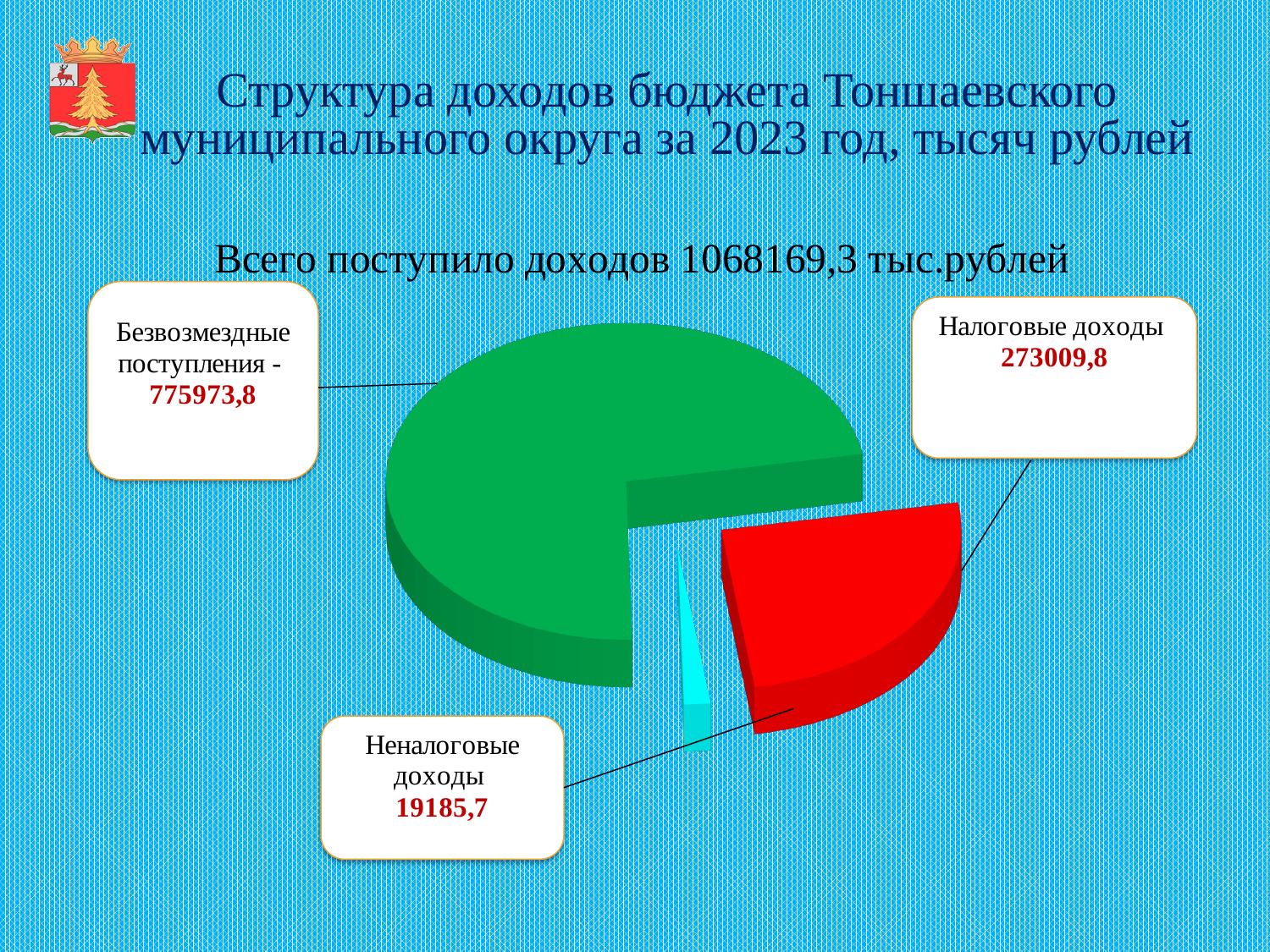
What is the total of all revenue shown on the slide? 1068169,3 тыс.рублей What is the value for Неналоговые доходы? 19185,7 Which category has the smallest slice of the pie? Неналоговые доходы What colour is the slice for Налоговые доходы? Red What year does the chart title refer to? 2023 What type of chart is shown on the slide? Pie chart How many slices does the pie chart have? 3 What is the value for Безвозмездные поступления? 775973,8 What is the value for Налоговые доходы? 273009,8 Which is larger, Налоговые доходы or Неналоговые доходы? Налоговые доходы Which category has the largest slice of the pie? Безвозмездные поступления What is the difference between Безвозмездные поступления and Налоговые доходы? 502964,0